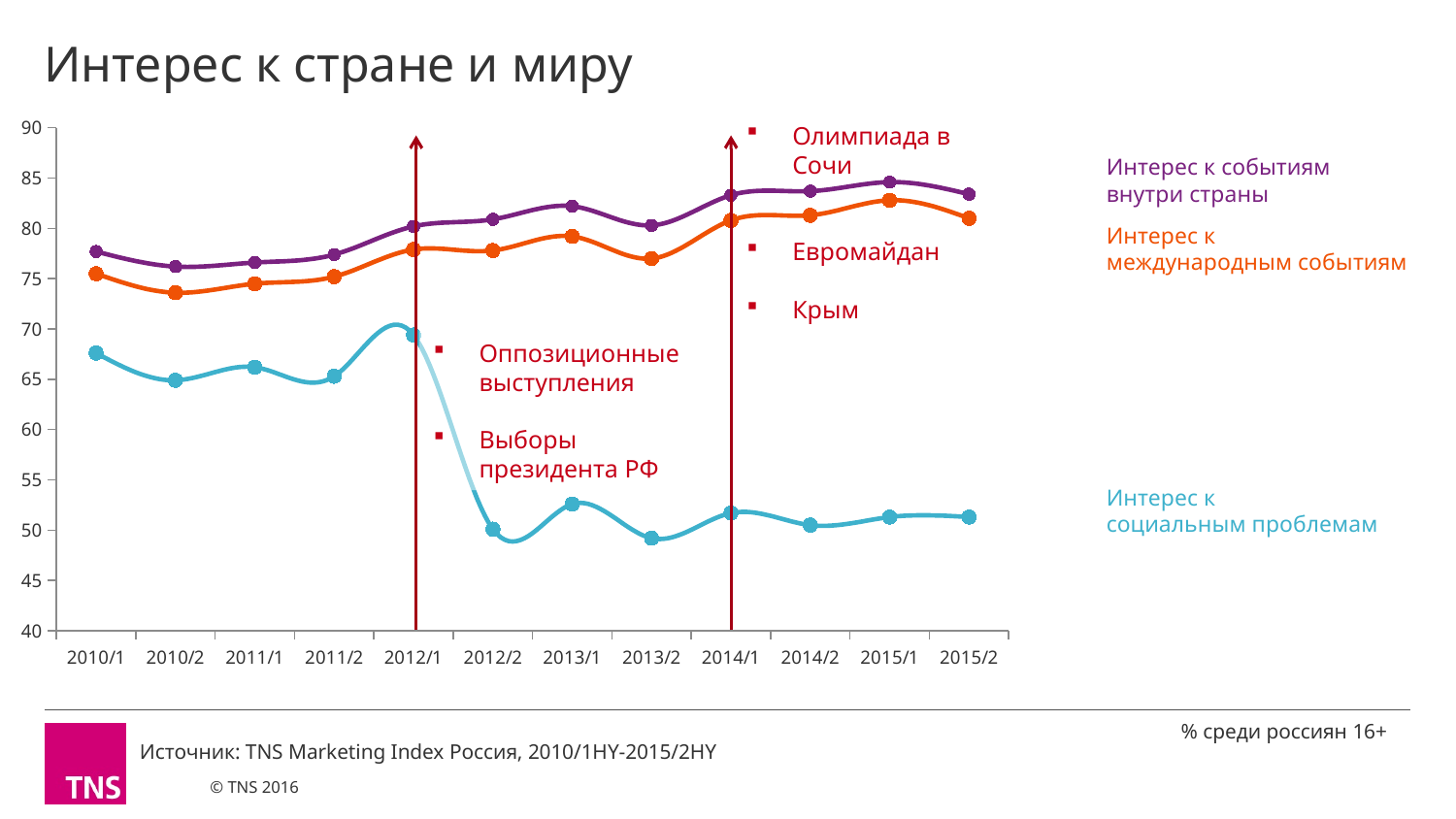
Does the series 'Интерес к социальным проблемам' rise or fall between 2012/1 and 2012/2? fall Is the value for 'Интерес к социальным проблемам' at 2010/1 greater or less than 65? greater Is the value for 'Интерес к международным событиям' at 2010/2 greater or less than 75? less Which series has the lowest value at 2014/1? Интерес к социальным проблемам How many time periods are shown on the x axis? 12 Which is larger at 2013/1: 'Интерес к событиям внутри страны' or 'Интерес к международным событиям'? Интерес к событиям внутри страны What kind of chart is shown on the slide? line chart Is the value for 'Интерес к событиям внутри страны' at 2015/1 greater or less than 80? greater At which period does the series 'Интерес к социальным проблемам' reach its highest value? 2012/1 How many series does the chart show? 3 What is the title of the chart? Интерес к стране и миру Which series has the highest value at 2012/1? Интерес к событиям внутри страны